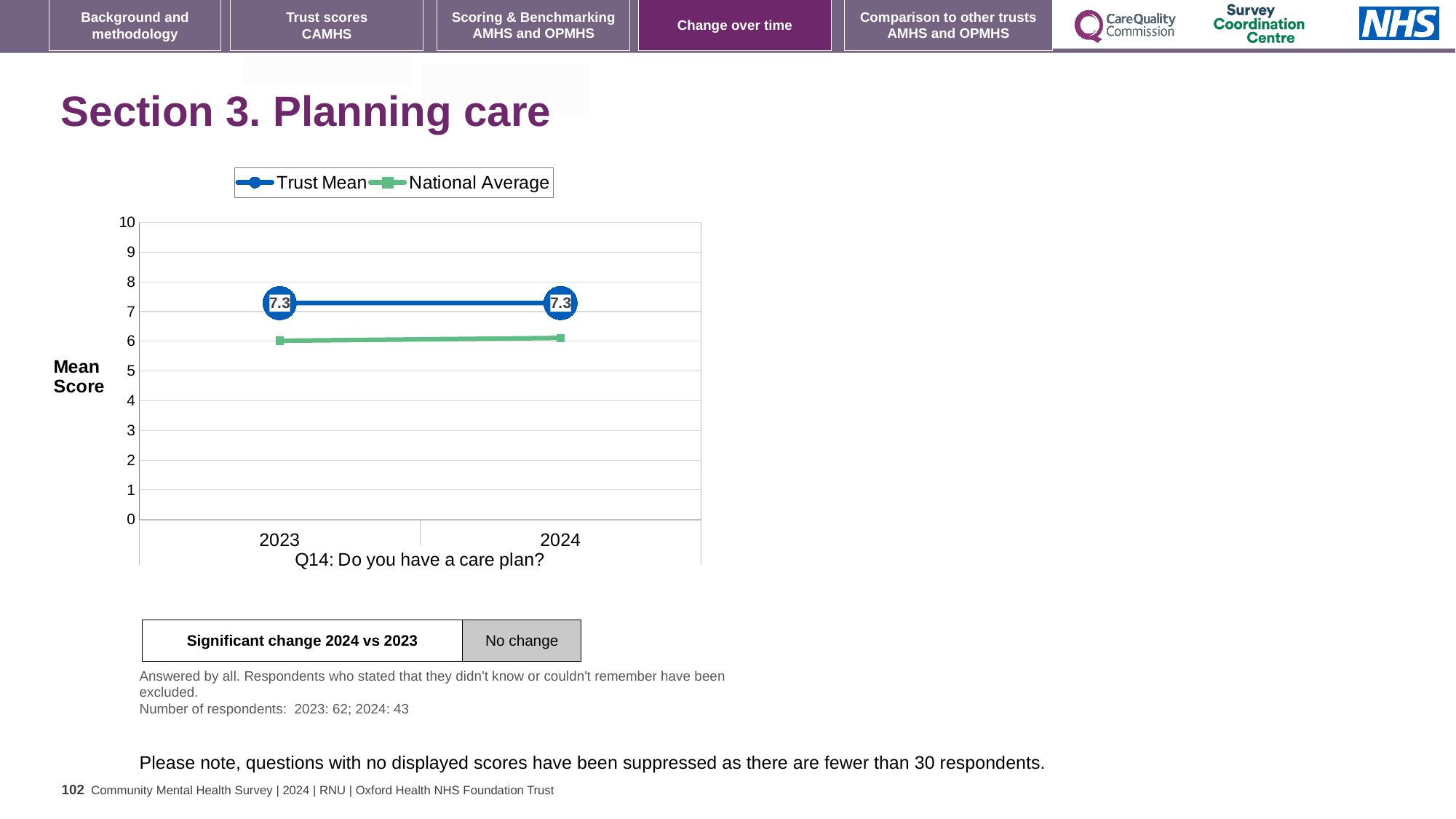
Which survey question does the chart relate to? Q14: Do you have a care plan? What is the label of the y axis? Mean Score In 2024, which is larger: the Trust Mean or the National Average? Trust Mean Is the National Average value for 2024 greater or less than 7? less What is the Trust Mean score for 2024? 7.3 Is the National Average value for 2023 greater or less than 5? greater What kind of chart is shown on the slide? line chart What is the Trust Mean score for 2023? 7.3 How many series does the legend list? 2 What is the difference between the Trust Mean scores for 2024 and 2023? 0 How many years are plotted on the x axis? 2 Does the Trust Mean rise, fall or stay the same from 2023 to 2024? stays the same